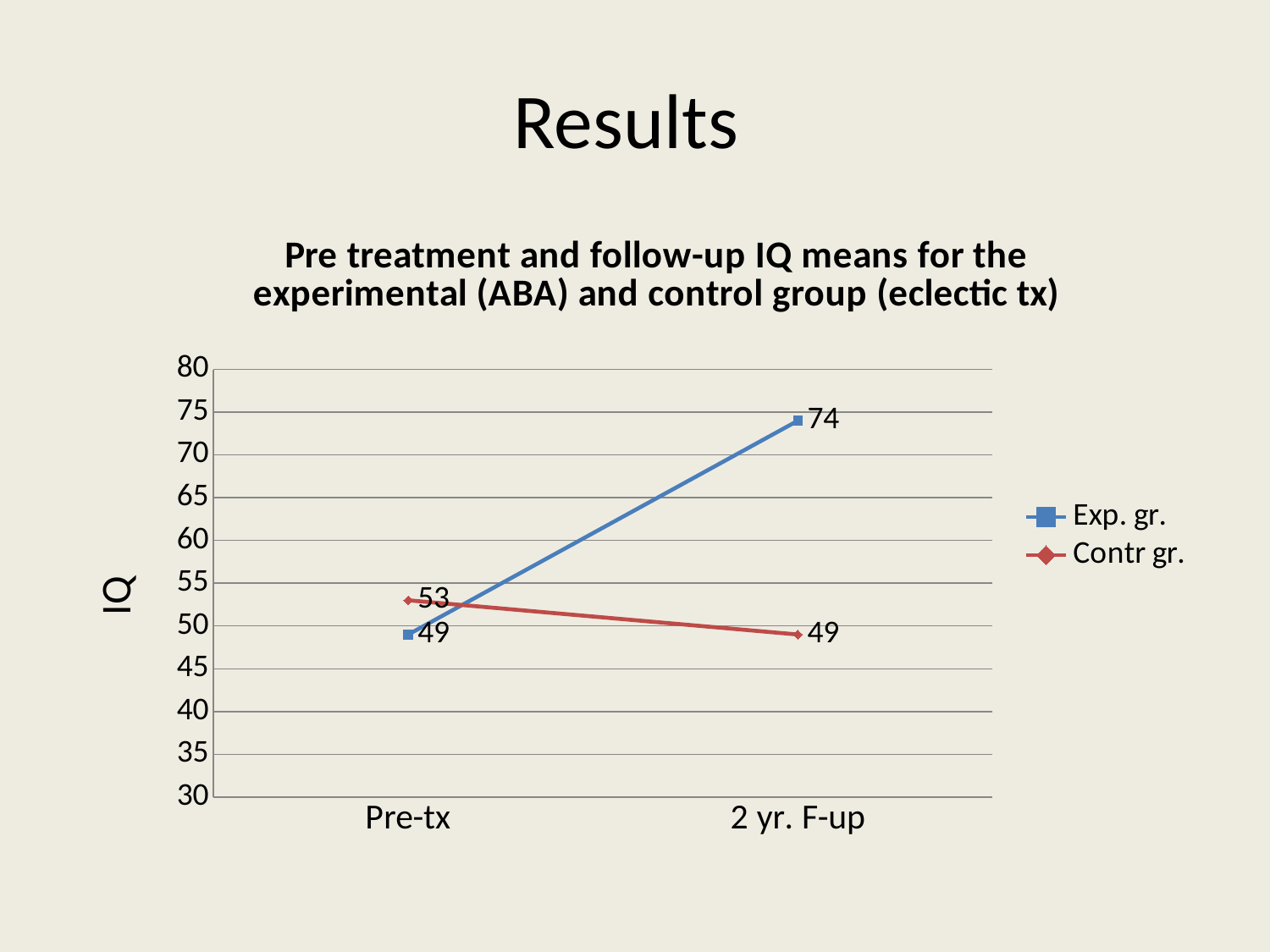
What is the IQ mean for the Contr gr. at 2 yr. F-up? 49 What is the IQ mean for the Exp. gr. at 2 yr. F-up? 74 What is the IQ mean for the Exp. gr. at Pre-tx? 49 What is the difference between the Exp. gr. IQ mean at 2 yr. F-up and at Pre-tx? 25 Which group has the higher IQ mean at 2 yr. F-up? Exp. gr. How many series does the legend list? 2 What is the difference between the Exp. gr. and Contr gr. IQ means at 2 yr. F-up? 25 Is the Contr gr. IQ mean at Pre-tx greater or less than the Exp. gr. IQ mean at Pre-tx? greater What kind of chart is shown on the slide? line chart Which group has the lower IQ mean at Pre-tx? Exp. gr. What is the IQ mean for the Contr gr. at Pre-tx? 53 Does the Contr gr. IQ mean rise or fall from Pre-tx to 2 yr. F-up? fall